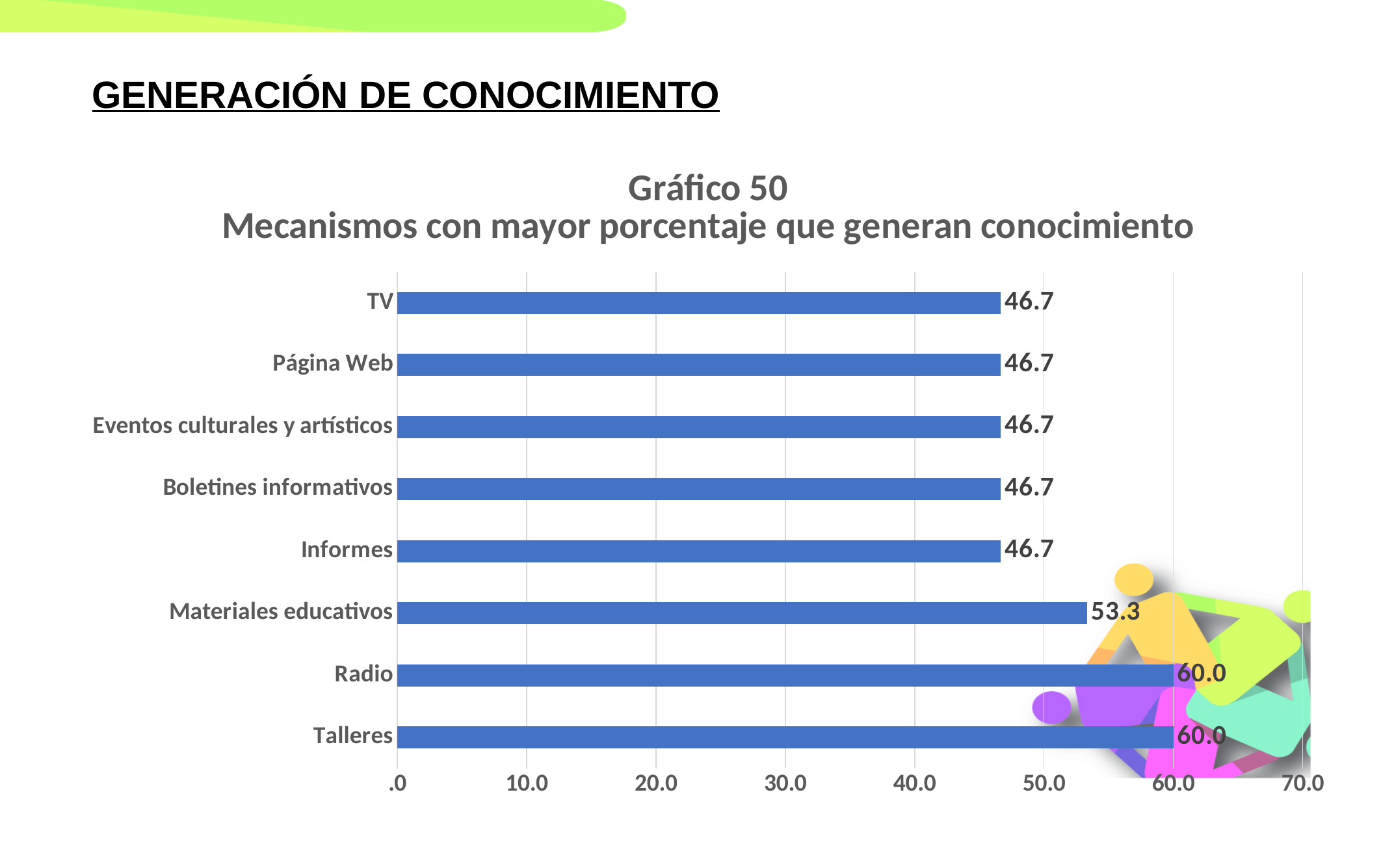
What is the difference between the values for Radio and Materiales educativos? 6.7 How many categories are shown in the chart? 8 What is the value for Materiales educativos? 53.3 What is the value for Radio? 60.0 What is the title of the chart? Gráfico 50 Mecanismos con mayor porcentaje que generan conocimiento What is the value for TV? 46.7 Which category has the lowest value among Materiales educativos, Radio and Talleres? Materiales educativos What is the difference between the values for Talleres and Informes? 13.3 Which is larger, the value for Materiales educativos or the value for Página Web? Materiales educativos Is the value for Eventos culturales y artísticos greater or less than 50.0? less What is the value for Boletines informativos? 46.7 What kind of chart is shown on the slide? bar chart